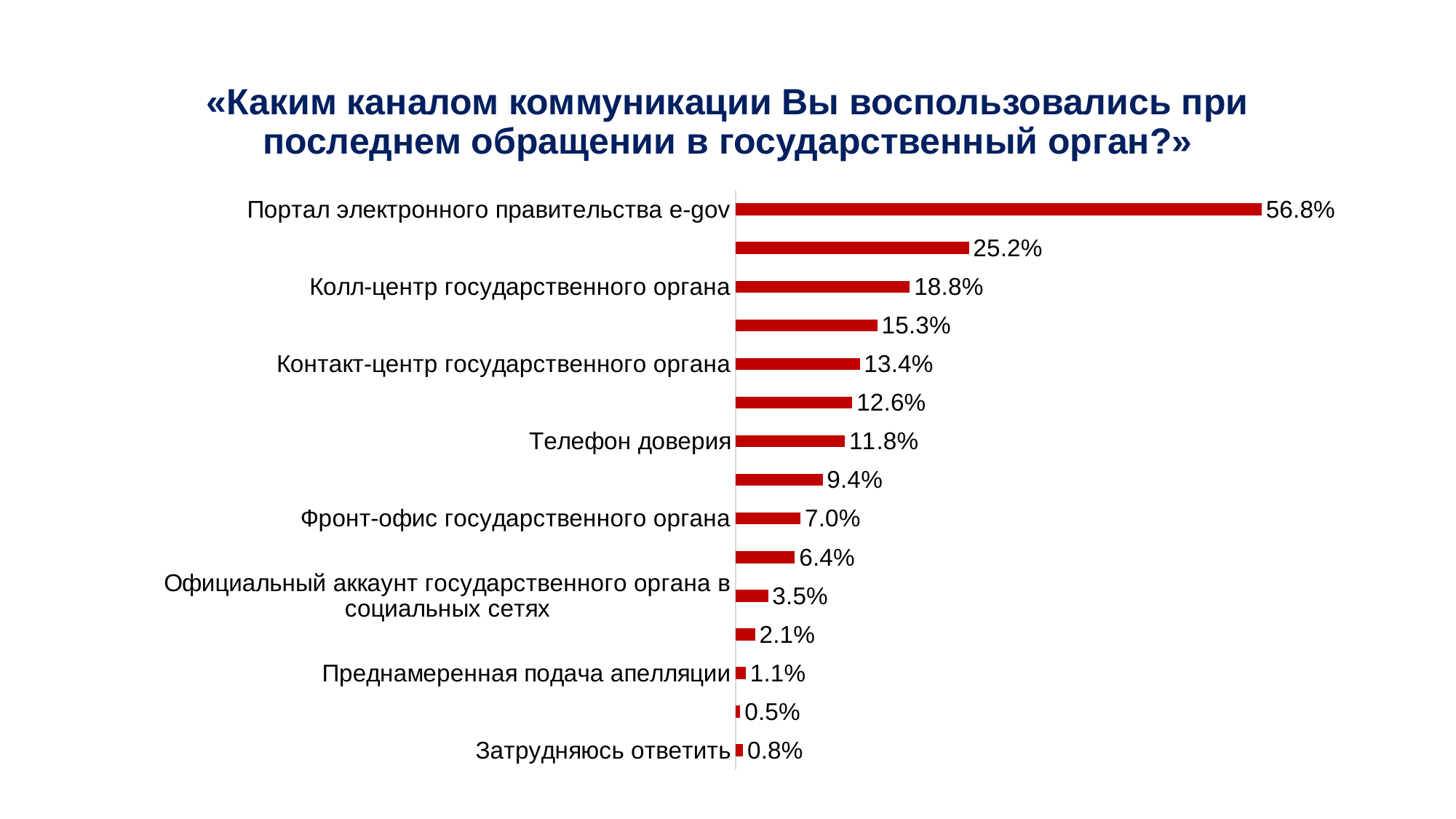
Which is larger: the value for Телефон доверия or the value for Фронт-офис государственного органа? Телефон доверия What is the value for Телефон доверия? 11.8% What is the value for Официальный аккаунт государственного органа в социальных сетях? 3.5% Which communication channel has the highest value? Портал электронного правительства e-gov What is the smallest value shown on the chart? 0.5% What is the value for Фронт-офис государственного органа? 7.0% What is the value for Контакт-центр государственного органа? 13.4% What is the value for Затрудняюсь ответить? 0.8% What kind of chart is shown on the slide? Bar chart What percentage of respondents used the e-gov electronic government portal (Портал электронного правительства e-gov)? 56.8% What is the difference between the values for Портал электронного правительства e-gov and Колл-центр государственного органа? 38.0% What is the value for Колл-центр государственного органа? 18.8%